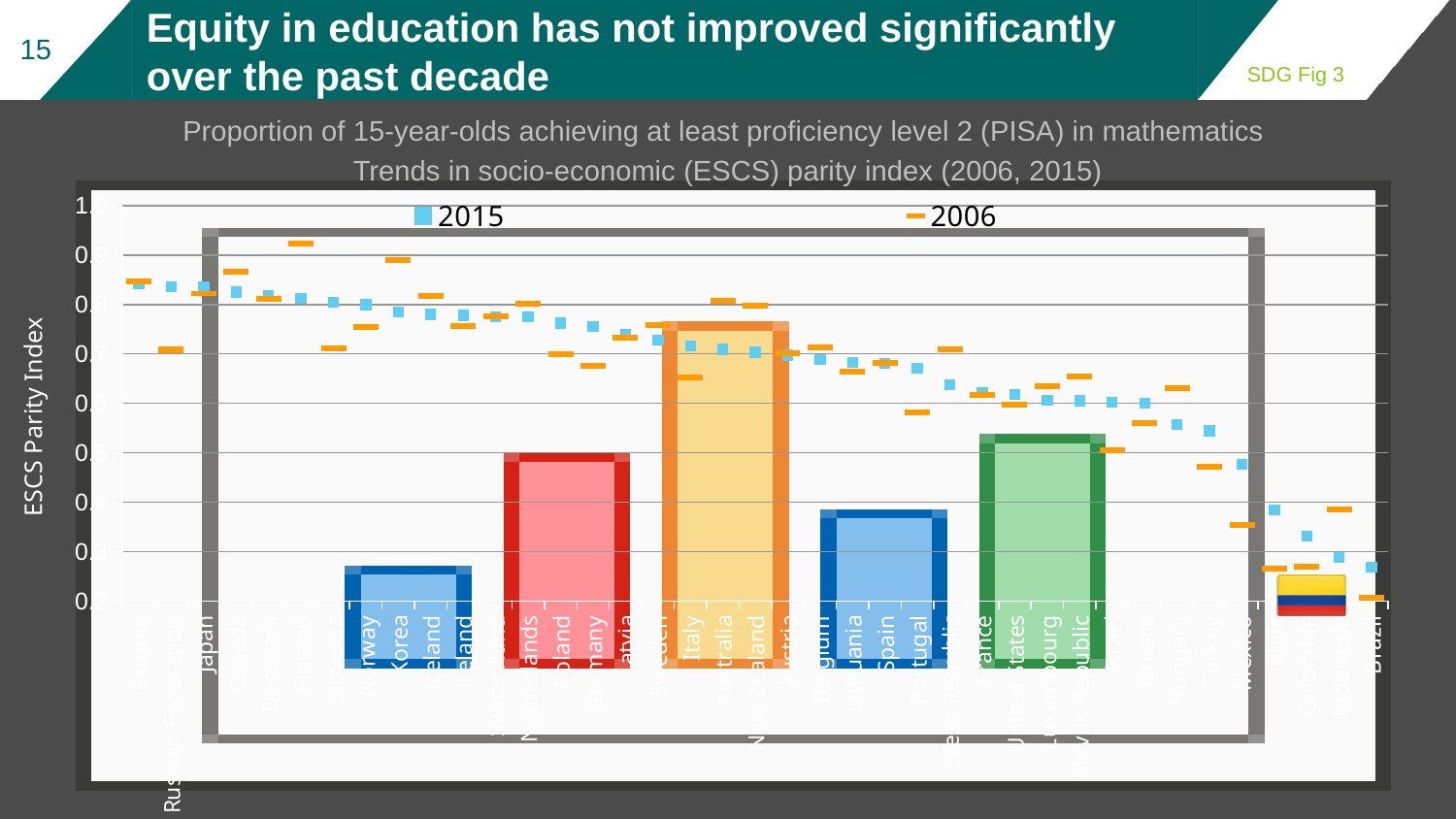
Which country has the highest 2006 value in the chart? Finland Which country has the lowest 2006 value in the chart? Brazil Is the 2006 value for Turkey greater or less than 0.5? less Is the 2006 value for Finland greater or less than 0.9? greater What is the title of the vertical axis of the chart? ESCS Parity Index How many series does the chart legend list? 2 Is the 2015 value for Brazil greater or less than 0.3? less Do the 2015 values generally rise or fall moving from left to right across the countries? fall What are the two series shown in the chart legend? 2015 and 2006 For Finland, which is larger: the 2006 value or the 2015 value? 2006